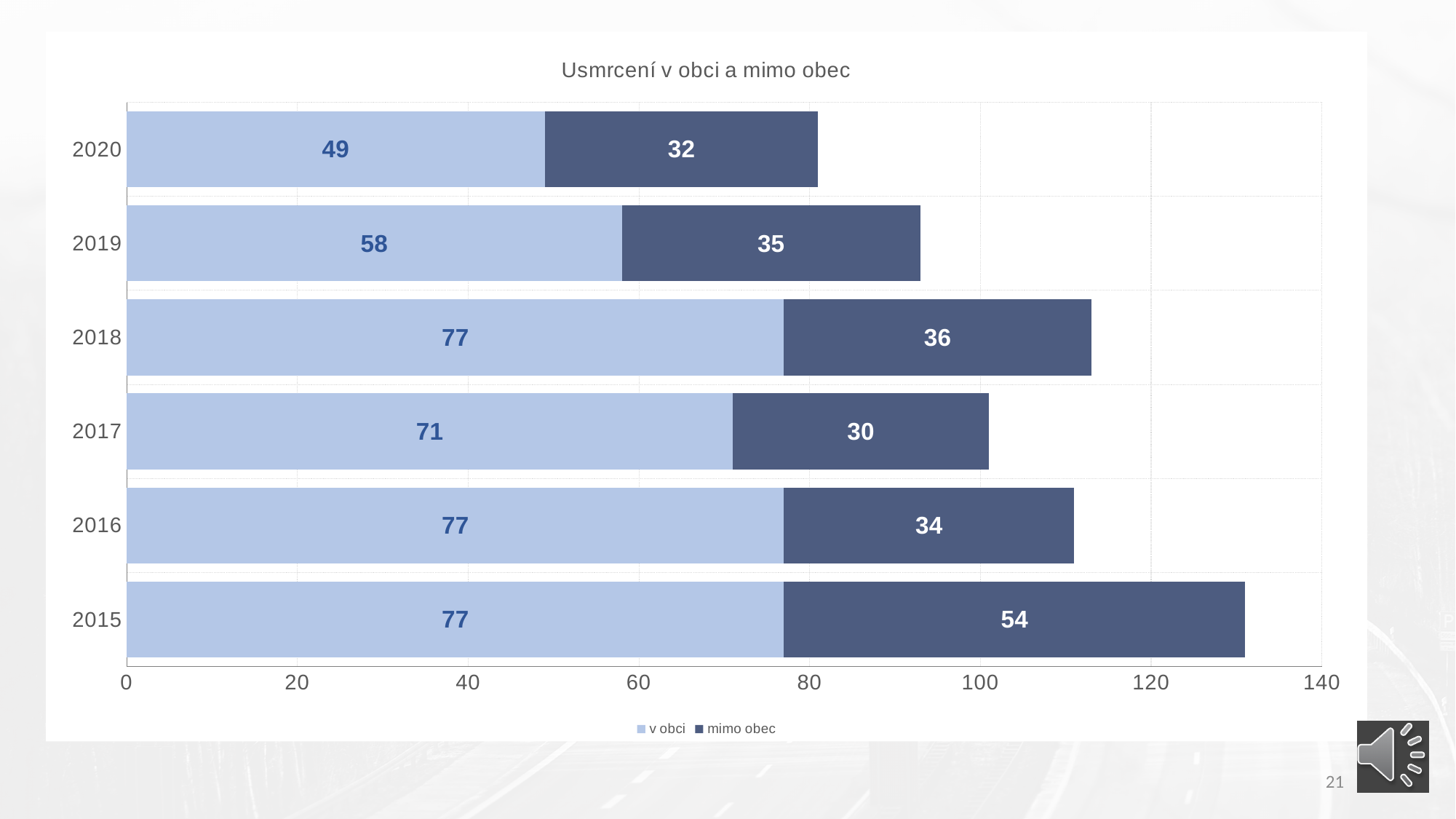
Which year has the lowest 'v obci' value? 2020 How many years are shown on the chart? 6 What is the value for 'mimo obec' in 2017? 30 What is the total of the stacked bar for 2020? 81 What is the value for 'v obci' in 2020? 49 What is the value for 'mimo obec' in 2015? 54 Which year has the highest 'mimo obec' value? 2015 What is the difference between the 'v obci' values for 2019 and 2020? 9 Which is larger: 'mimo obec' in 2018 or 'mimo obec' in 2019? 2018 What is the title of the chart? Usmrcení v obci a mimo obec What is the total of the stacked bar for 2015? 131 How many series does the legend list? 2